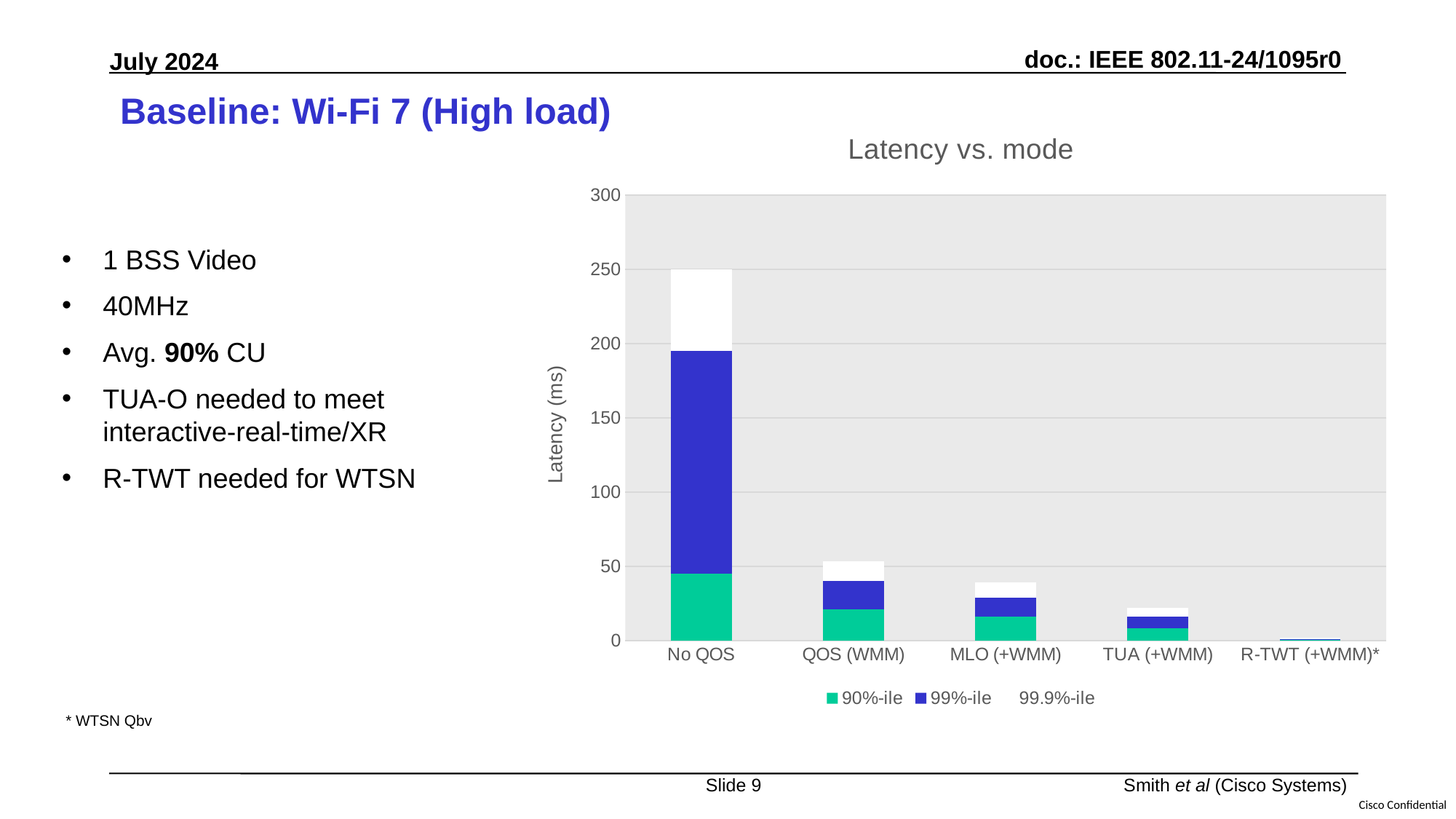
Do the total latency bars rise or fall moving from left to right along the x axis? fall How many modes (categories) are plotted on the x axis? 5 Which mode has the lowest total latency bar? R-TWT (+WMM)* Is the 90%-ile value for No QOS greater or less than 50? less Is the total bar height for No QOS greater or less than 200? greater Which mode has the highest total latency bar? No QOS Which has the taller total bar, QOS (WMM) or MLO (+WMM)? QOS (WMM) Is the total bar height for QOS (WMM) greater or less than 100? less How many series does the legend list? 3 What kind of chart is shown on the slide? stacked bar chart What is the title of the chart? Latency vs. mode